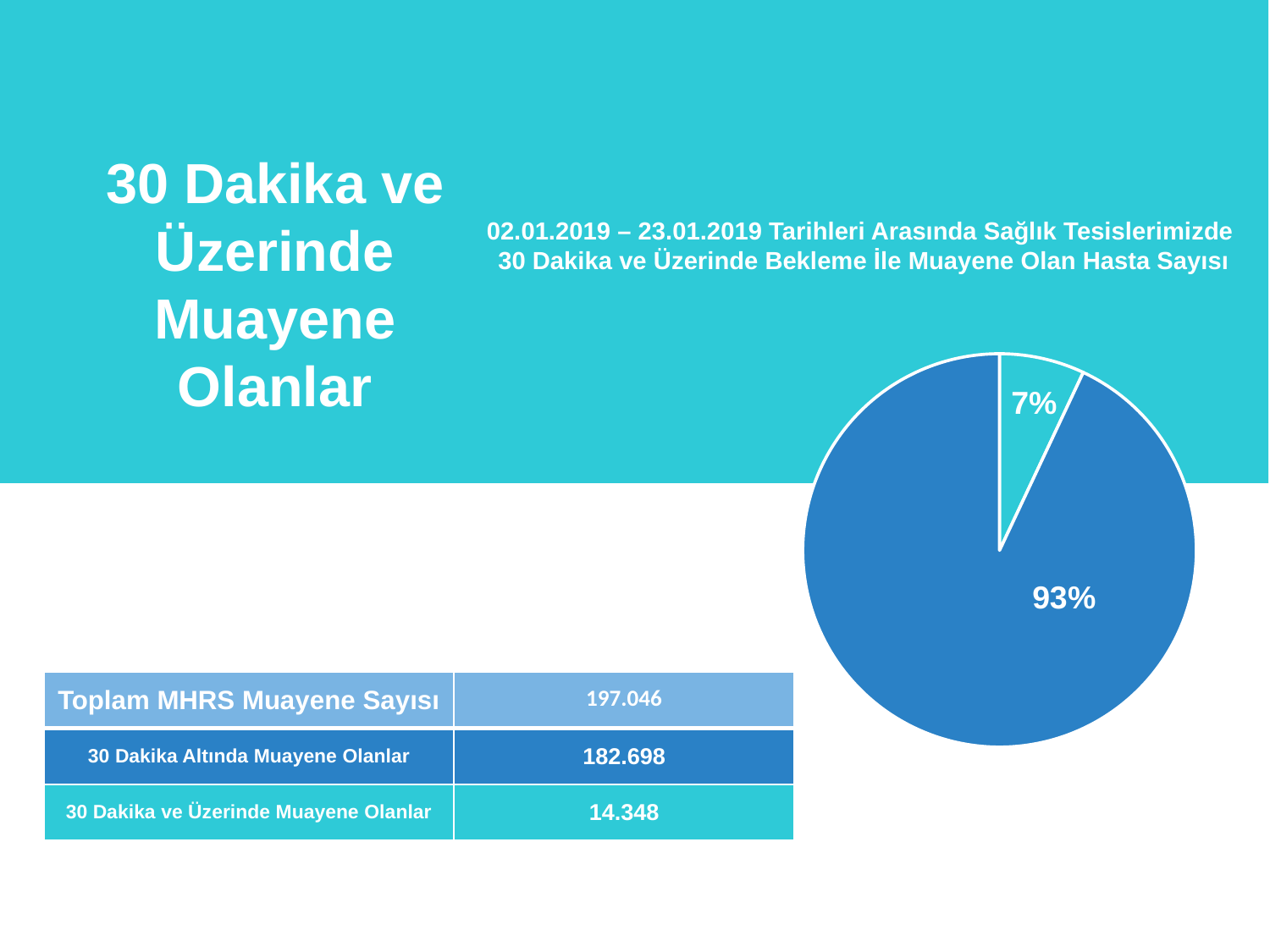
What percentage label is on the dark blue slice of the pie chart? 93% What date range is given in the pie chart's title? 02.01.2019 – 23.01.2019 In the table below the chart, what value is given for 30 Dakika ve Üzerinde Muayene Olanlar? 14.348 Is the light teal slice of the pie chart larger or smaller than the dark blue slice? Smaller What percentage label is on the light teal slice of the pie chart? 7% Is the smaller slice of the pie chart greater or less than 10%? Less What percentage is shown on the largest slice of the pie chart? 93% What is the difference in percentage points between the two slices of the pie chart? 86 How many slices does the pie chart have? 2 What kind of chart is shown on the slide? Pie chart What do the two slice percentages of the pie chart add up to? 100% What percentage is shown on the smallest slice of the pie chart? 7%